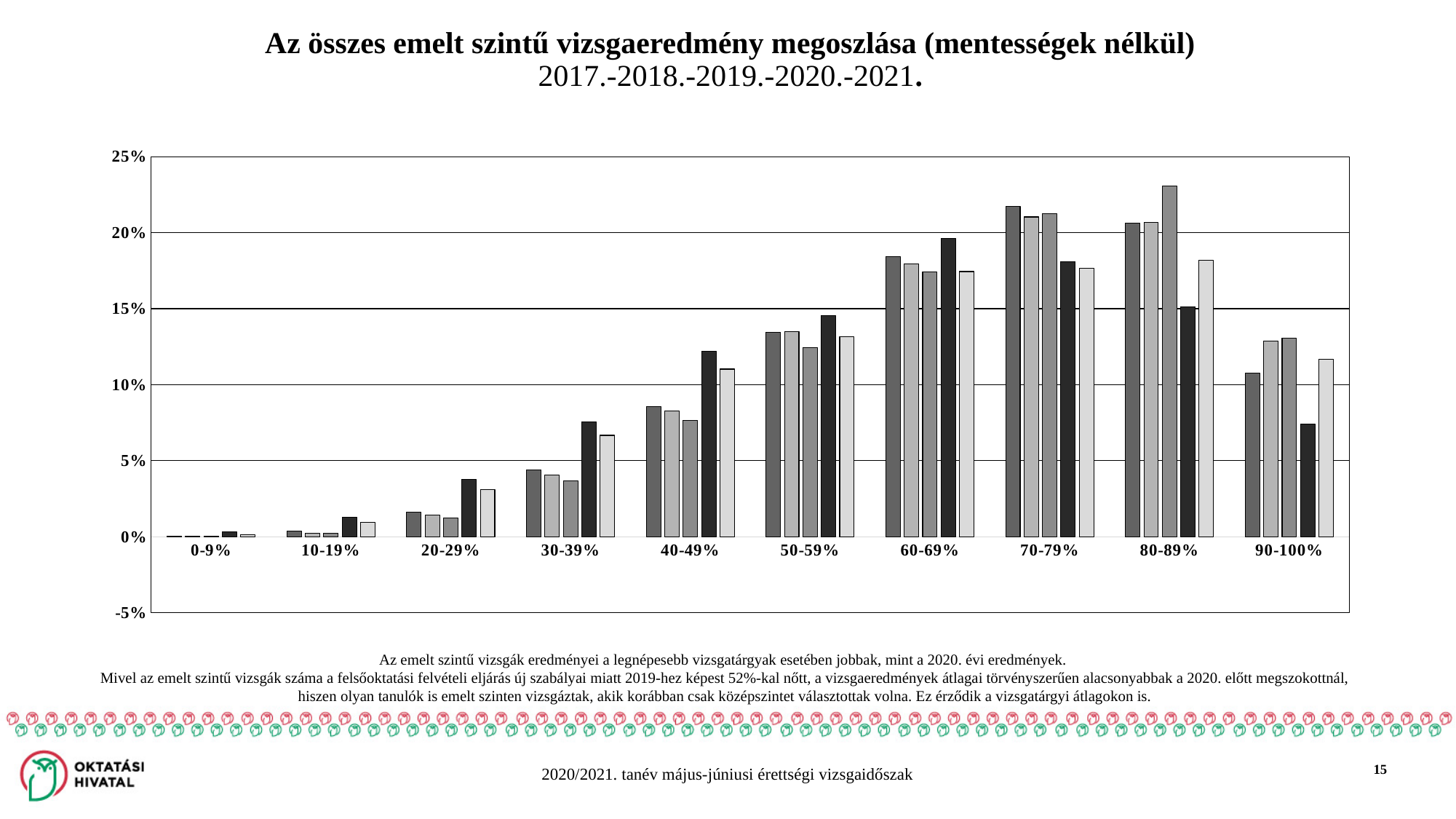
What kind of chart is shown on the slide? bar chart Is the value of the first (leftmost) bar in the 60-69% category greater or less than 15%? greater Is the value of the black bar in the 90-100% category greater or less than 10%? less In the 30-39% category, is the black bar taller or shorter than the first (leftmost) bar? taller How many bars are plotted for each score-band category? 5 Is the value of the first (leftmost) bar in the 70-79% category greater or less than 20%? greater In the 90-100% category, is the black bar taller or shorter than the first (leftmost) bar? shorter How many score-band categories are shown along the x axis? 10 Do the bar values generally rise or fall from the 0-9% category to the 70-79% category? rise What is the lowest tick value shown on the vertical axis? -5% Which score-band category has the lowest bars in the chart? 0-9% Which score-band category contains the tallest bar in the chart? 80-89%